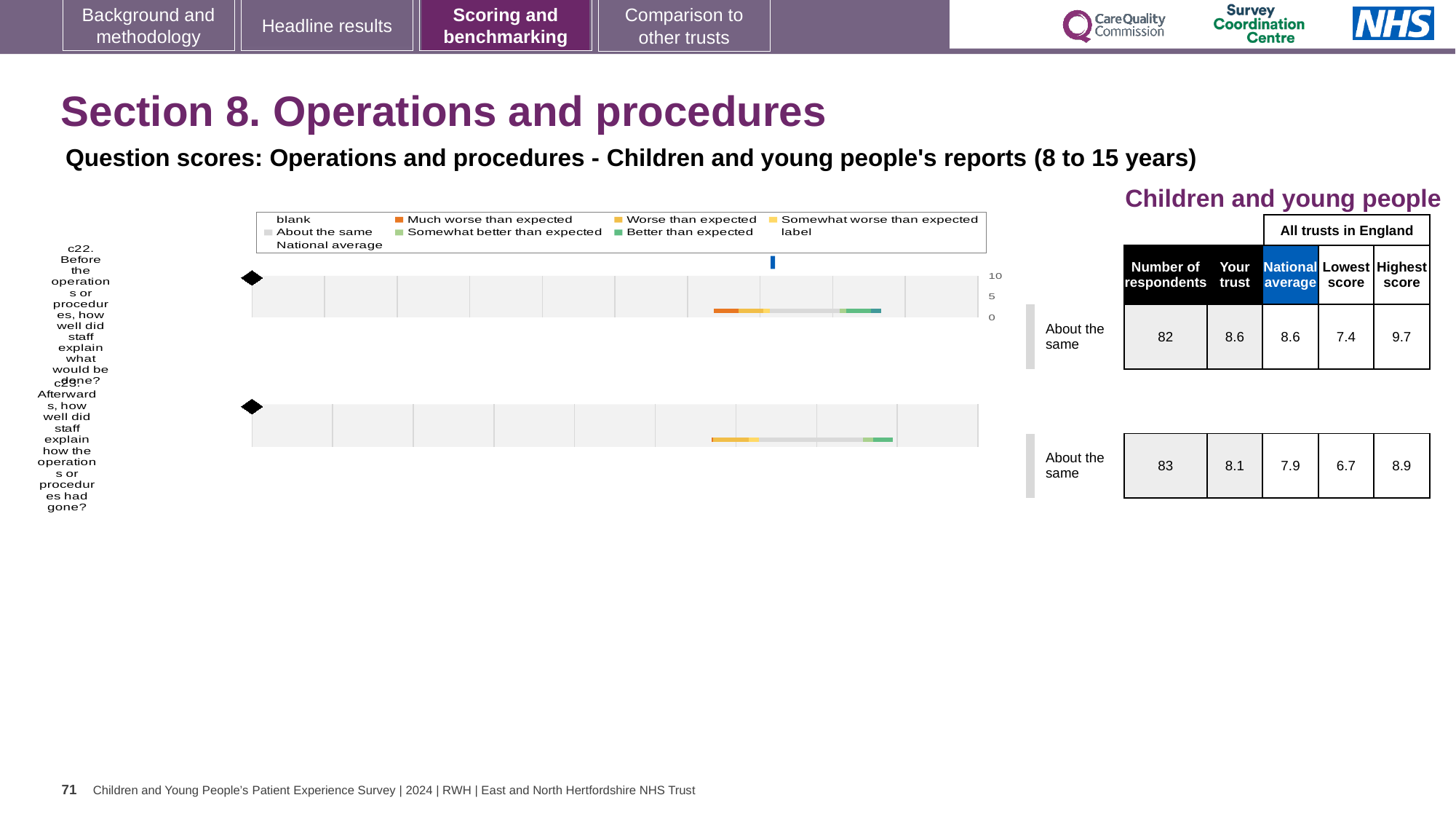
What is the lowest score across all trusts in England for question c22? 7.4 What is the difference between the highest score and the lowest score for question c22? 2.3 In the chart legend, which category is shown in orange? Much worse than expected What is the 'Your trust' score for question c22 (Before the operations or procedures, how well did staff explain what would be done?)? 8.6 How many questions (c22 and c23) are plotted on the slide? 2 What benchmark category is shown for question c22? About the same What kind of chart is used to show the question scores for c22 and c23? bar chart What is the difference between the highest score and the lowest score for question c23? 2.2 What is the national average score for question c23 (Afterwards, how well did staff explain how the operations or procedures had gone?)? 7.9 Which question has the higher 'Your trust' score, c22 or c23? c22 How many respondents answered question c23? 83 For question c23, which is larger: the 'Your trust' score or the national average? Your trust